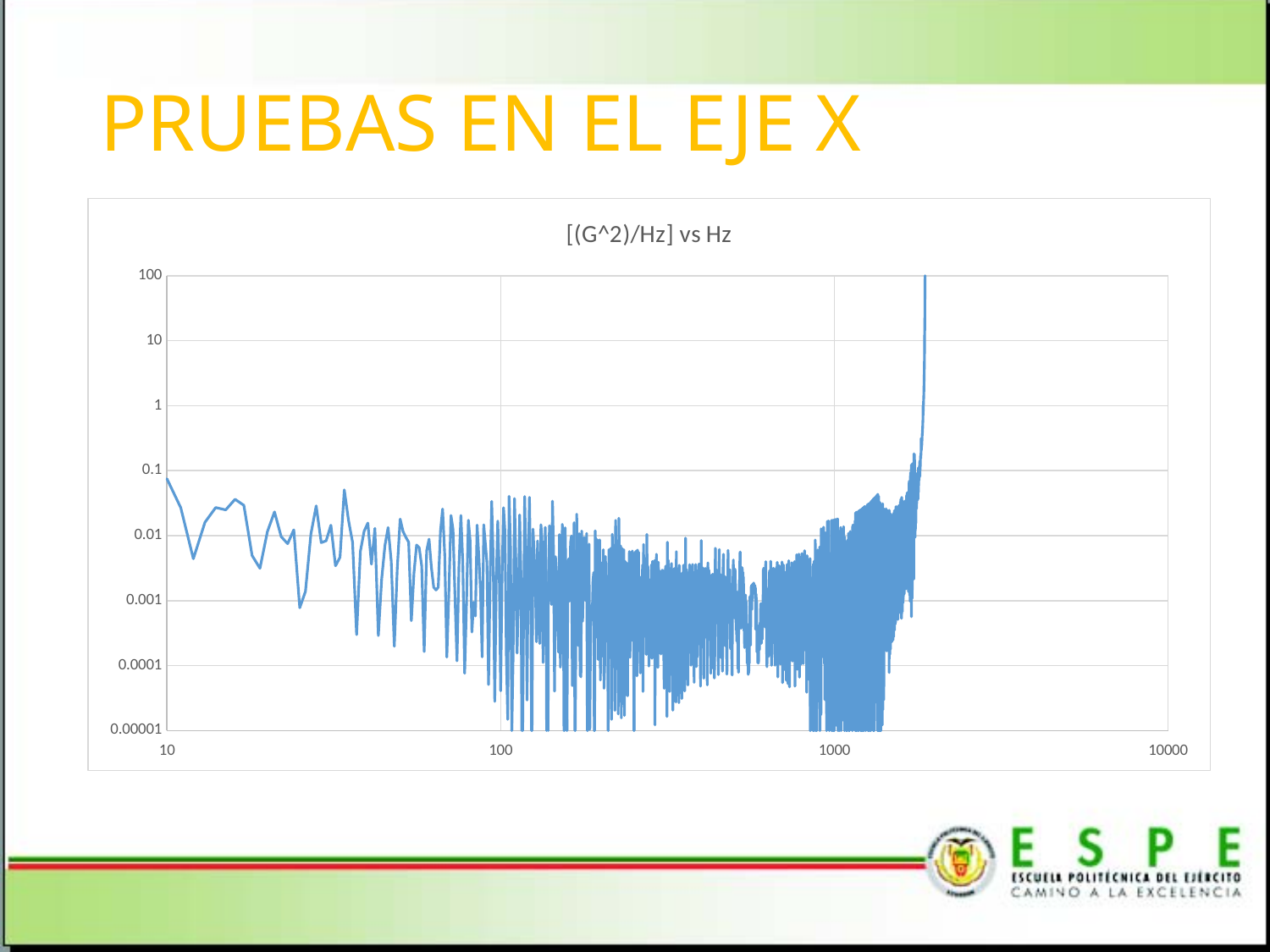
What is the largest value labelled on the x axis? 10000 Is the value of the line at 10 Hz greater or less than 1? less Is the peak value reached by the line at its right-hand end (near 2000 Hz) greater or less than 1? greater What kind of chart is shown on the slide? line chart What colour is the plotted line in the chart? blue Is the value of the line at 10 Hz greater or less than 0.01? greater How many tick labels are shown on the y axis? 8 What is the title of the chart? [(G^2)/Hz] vs Hz What is the highest value labelled on the y axis? 100 What is the lowest value labelled on the y axis? 0.00001 How many tick labels are shown on the x axis? 4 Does the line rise or fall sharply at its right-hand end, just before 2000 Hz? rises